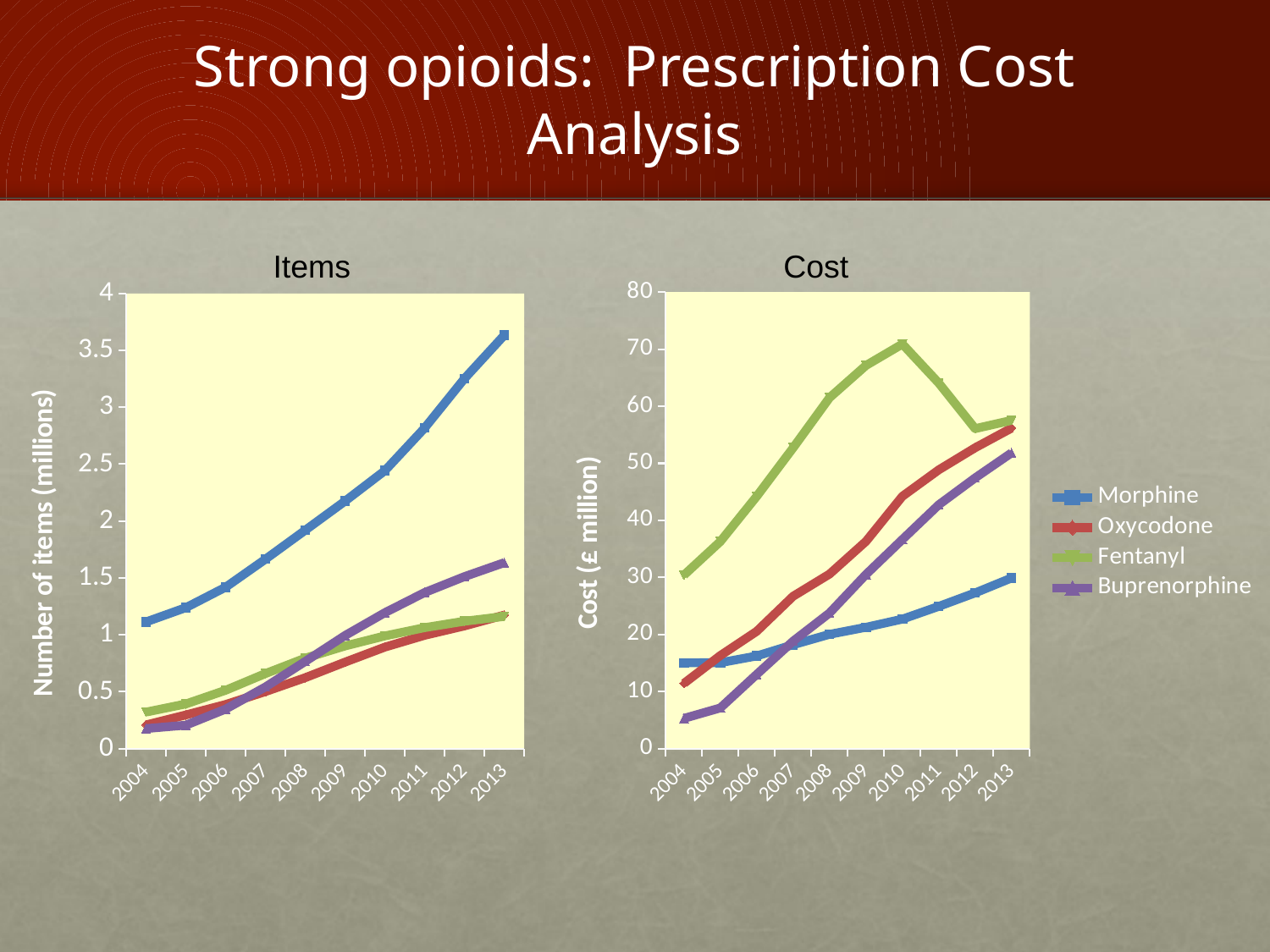
What kind of chart is the Items chart? line chart What is the y-axis label of the Cost chart? Cost (£ million) In the Cost chart, which series has the highest value in 2010? Fentanyl In the Items chart, is the value for Morphine in 2013 greater or less than 3? greater In the Items chart, which series has the highest value in 2013? Morphine In the Items chart, is the value for Fentanyl in 2004 greater or less than 0.5? less In the Cost chart, which series has the lowest value in 2004? Buprenorphine How many years are plotted on the x axis of the Cost chart? 10 In the Cost chart, which is larger in 2013: Oxycodone or Morphine? Oxycodone How many series does the legend list? 4 In the Items chart, do the values for Morphine rise or fall from 2004 to 2013? rise In the Cost chart, is the value for Fentanyl in 2010 greater or less than 60? greater